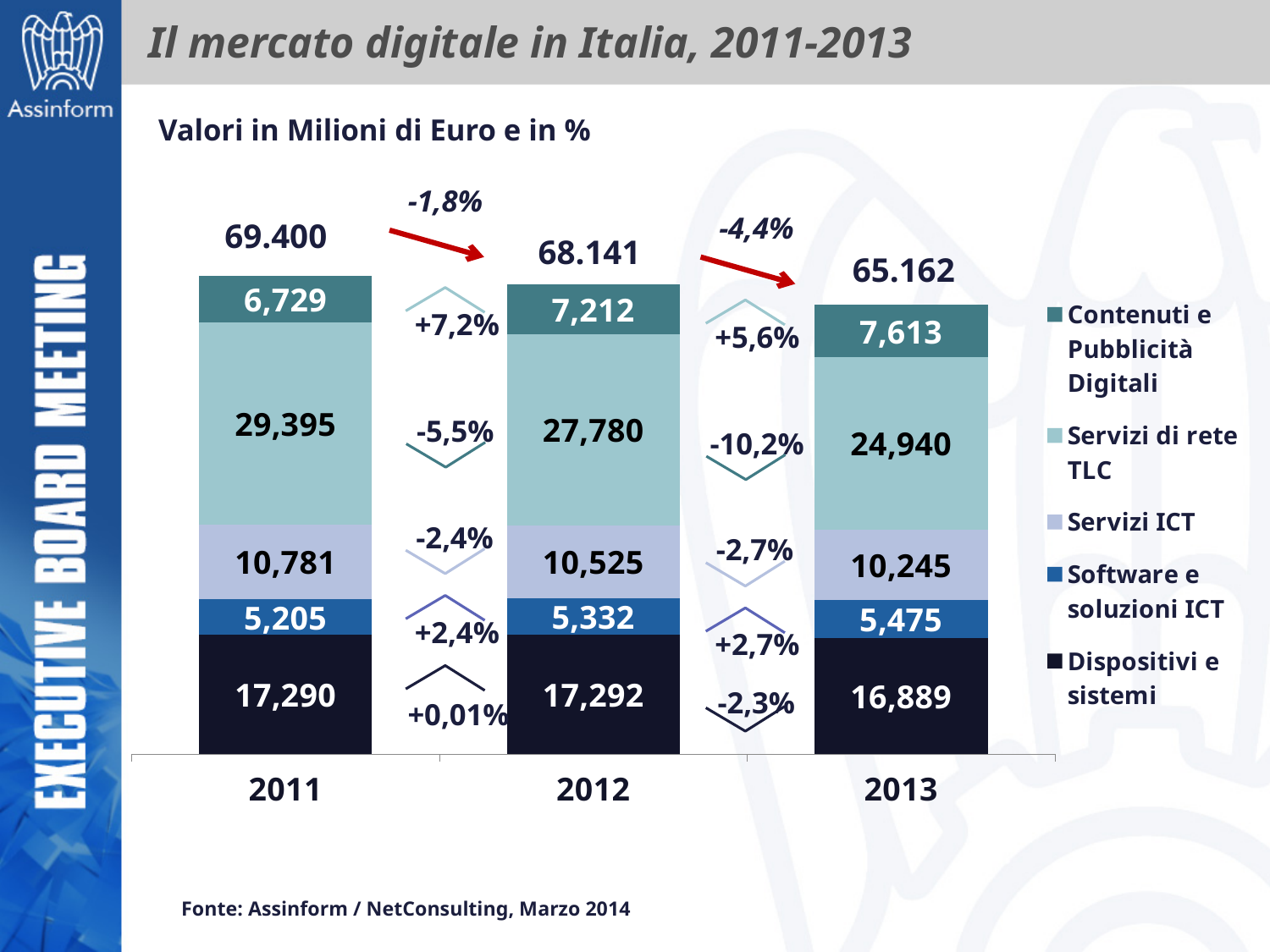
Is the value for Software e soluzioni ICT larger in 2011 or in 2013? 2013 What is the value for Servizi di rete TLC in 2012? 27,780 How many series does the legend list? 5 How many years are shown on the x axis? 3 What is the value for Contenuti e Pubblicità Digitali in 2011? 6,729 Which year has the highest total value? 2011 Which series has the smallest value in 2012? Software e soluzioni ICT What is the difference between the Servizi ICT value in 2011 and in 2013? 536 What is the total of the stacked bar for 2013? 65.162 Does the value for Servizi di rete TLC rise or fall from 2011 to 2013? Fall What kind of chart is shown on the slide? Stacked bar chart What is the value for Dispositivi e sistemi in 2013? 16,889